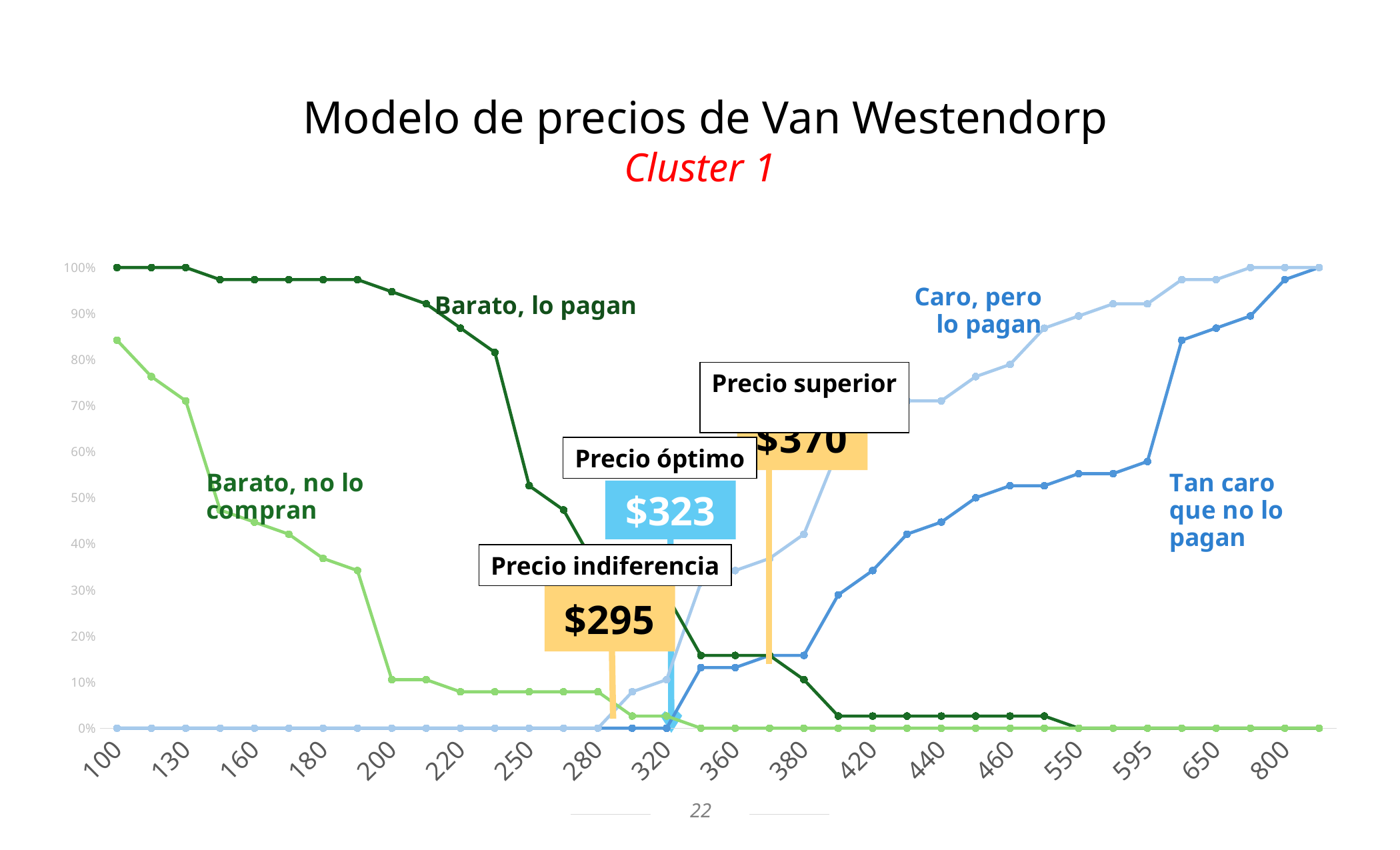
What price is labelled as 'Precio indiferencia'? $295 How many data series are labelled on the chart? 4 Does the 'Tan caro que no lo pagan' series rise or fall as the price increases along the x axis? rise What is the value of the 'Barato, lo pagan' series at a price of 100? 100% Does the 'Barato, lo pagan' series rise or fall as the price increases along the x axis? fall What kind of chart is shown on the slide? line chart What is the title of the chart on the slide? Modelo de precios de Van Westendorp Which cluster does the chart subtitle refer to? Cluster 1 What price is labelled as 'Precio superior'? $370 What price is labelled as 'Precio óptimo'? $323 What is the difference between the 'Precio superior' and the 'Precio indiferencia'? $75